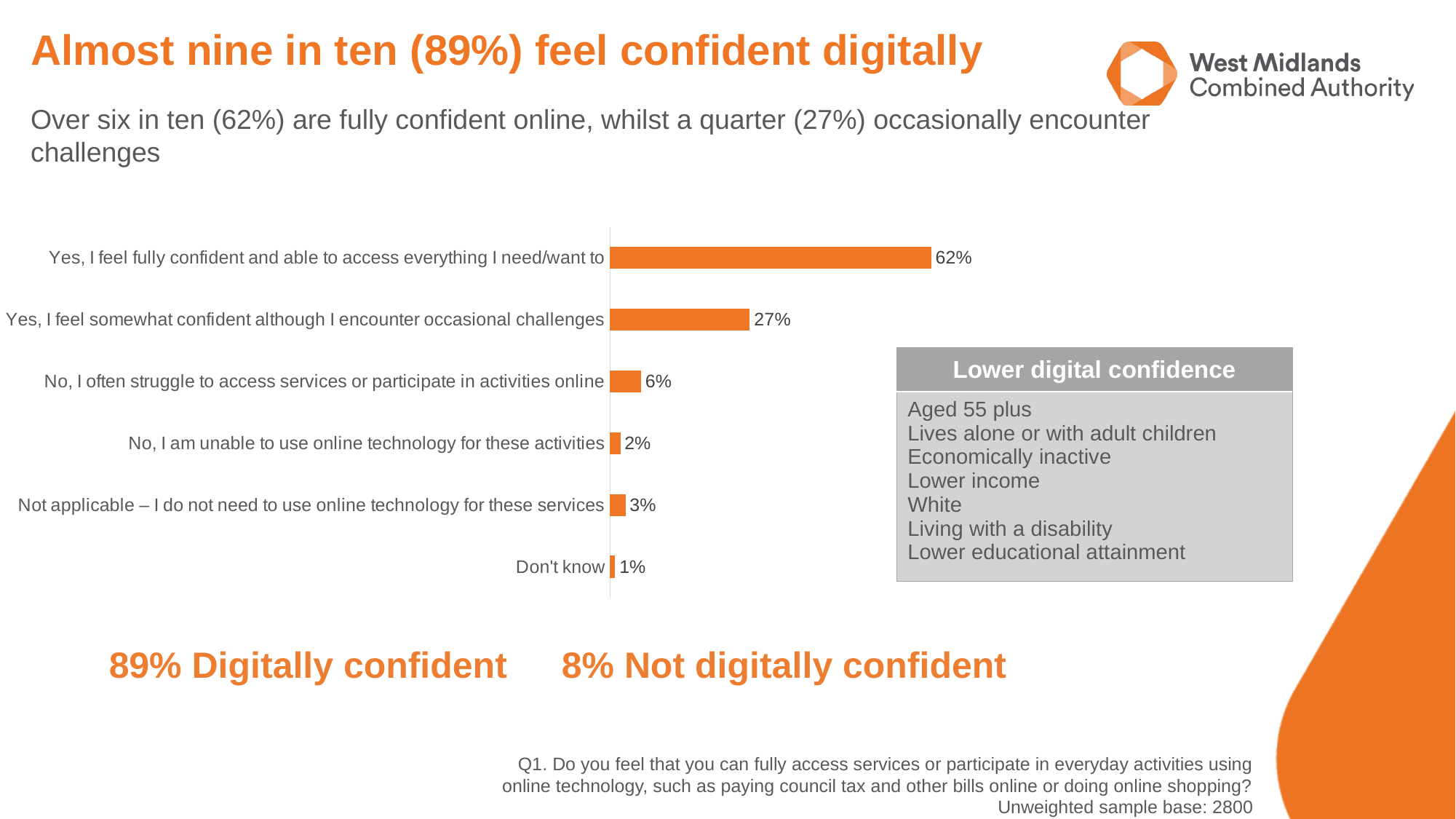
What is the combined percentage of the two 'No' responses (6% and 2%)? 8% Which is larger: the value for 'No, I am unable to use online technology for these activities' or the value for 'Not applicable – I do not need to use online technology for these services'? Not applicable – I do not need to use online technology for these services How many response categories are shown in the chart? 6 What percentage of respondents answered 'Don't know'? 1% What percentage of respondents said they often struggle to access services or participate in activities online? 6% What percentage of respondents said they feel fully confident and able to access everything they need/want to? 62% Which response category has the lowest value in the chart? Don't know What type of chart is shown on the slide? Bar chart Which response category has the highest value in the chart? Yes, I feel fully confident and able to access everything I need/want to What is the difference in percentage points between 'fully confident' (62%) and 'somewhat confident' (27%)? 35 percentage points What is the title of the grey box to the right of the chart? Lower digital confidence What percentage of respondents said they feel somewhat confident although they encounter occasional challenges? 27%